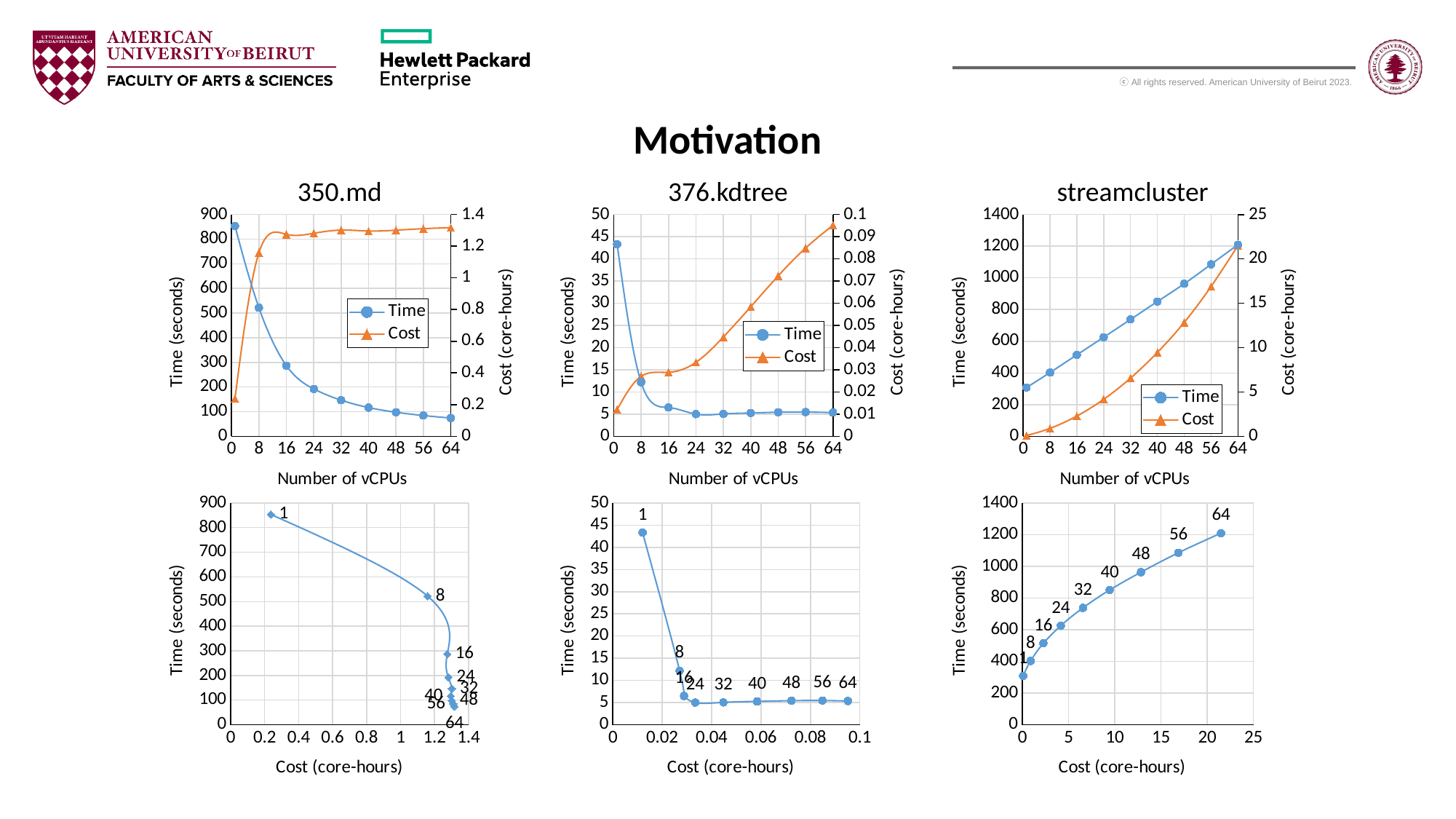
In the streamcluster chart (top right), is the Time value at 64 vCPUs greater or less than 1000 seconds? greater In the 376.kdtree chart (top middle), which is larger: the Cost at 64 vCPUs or the Cost at 8 vCPUs? Cost at 64 vCPUs How many labelled data points are plotted in the bottom-left Time versus Cost chart? 9 In the 350.md chart (top left), is the Cost value at 64 vCPUs greater or less than 1.2 core-hours? greater What kind of chart is the 350.md chart at the top left of the slide? line chart In the 376.kdtree chart (top middle), is the Time value at 1 vCPU greater or less than 40 seconds? greater How many series does the legend of the 376.kdtree chart list? 2 What is the x-axis label of the three charts in the top row? Number of vCPUs In the streamcluster chart (top right), does the Time series rise or fall as the number of vCPUs increases? rise In the 350.md chart (top left), does the Time series rise or fall as the number of vCPUs increases? fall In the 376.kdtree chart (top middle), does the Cost series rise or fall as the number of vCPUs increases from 8 to 64? rise